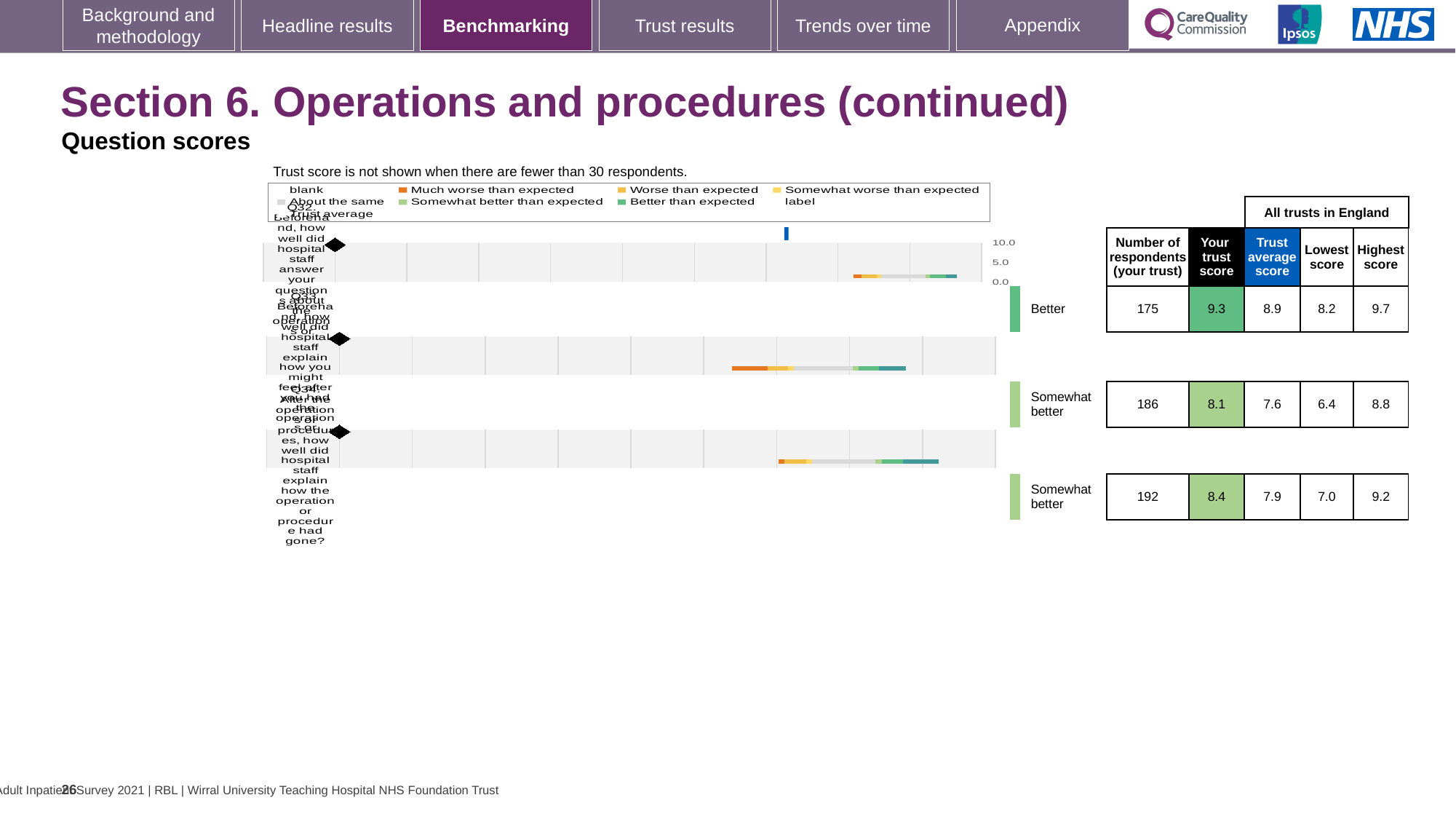
What is 'Your trust score' for the top row of the chart (rated 'Better')? 9.3 Which has more respondents: the second row (186) or the third row (192)? the third row Which row has the highest 'Your trust score'? the top row (Better), 9.3 How many question rows are plotted in the benchmarking chart? 3 What is the lowest score across all trusts in England for the second row of the chart? 6.4 Which row has the lowest 'Your trust score'? the second row (Somewhat better), 8.1 What is the highest score across all trusts in England for the third row of the chart? 9.2 What is the trust average score for the top row of the chart? 8.9 What kind of chart is used to show the question scores on this slide? bar chart What is the maximum value shown on the chart's score axis? 10.0 What is the number of respondents for the top row of the chart (rated 'Better')? 175 For the top row, how much higher is 'Your trust score' than the trust average score? 0.4